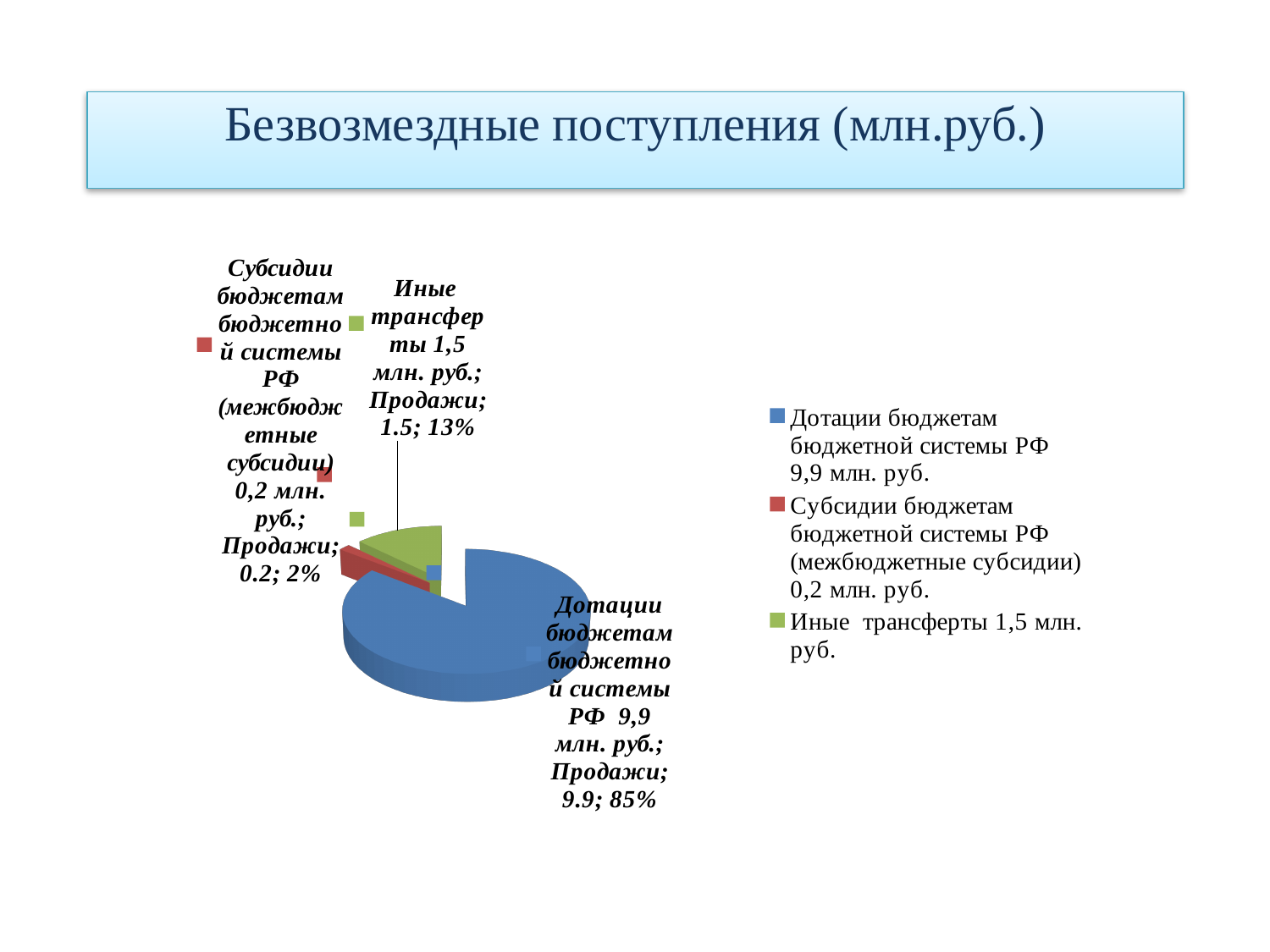
Which category has the largest slice? Дотации бюджетам бюджетной системы РФ How many slices does the pie chart have? 3 Which category has the smallest slice? Субсидии бюджетам бюджетной системы РФ (межбюджетные субсидии) How many entries does the legend list? 3 What kind of chart is shown on the slide? pie chart What value is shown for Субсидии бюджетам бюджетной системы РФ (межбюджетные субсидии)? 0.2 What is the title of the chart? Безвозмездные поступления (млн.руб.) What value is shown for Иные трансферты? 1.5 What share of the pie does Дотации бюджетам бюджетной системы РФ represent? 85% What is the difference between the values for Дотации бюджетам бюджетной системы РФ and Иные трансферты? 8.4 What value is shown for Дотации бюджетам бюджетной системы РФ? 9.9 What share of the pie does Иные трансферты represent? 13%